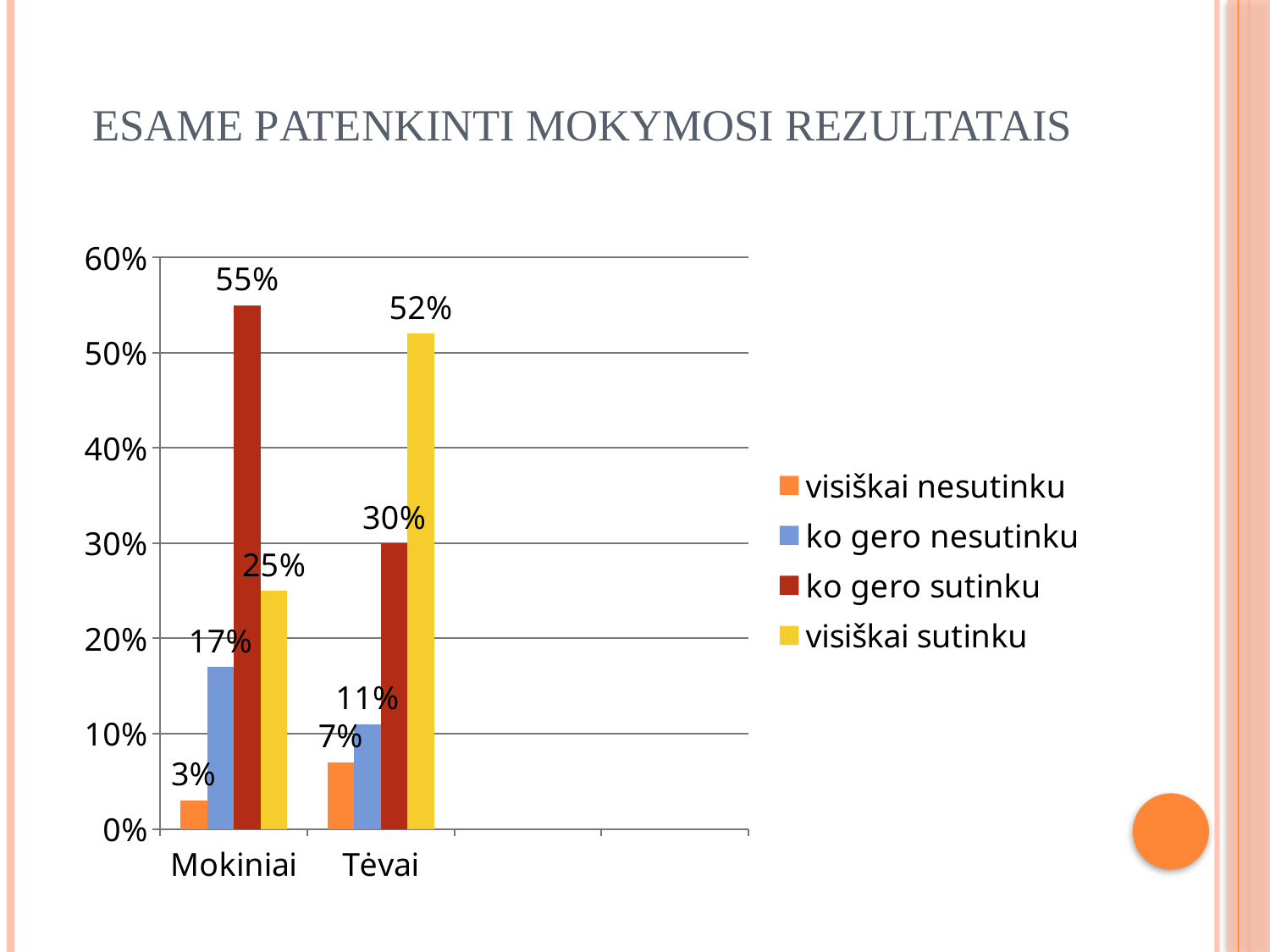
Which response category has the lowest value for Mokiniai? visiškai nesutinku What is the value for 'ko gero sutinku' for Mokiniai? 55% What kind of chart is shown on the slide? bar chart What is the title of the slide? ESAME PATENKINTI MOKYMOSI REZULTATAIS What is the value for 'visiškai nesutinku' for Mokiniai? 3% What is the value for 'visiškai sutinku' for Tėvai? 52% What is the value for 'ko gero nesutinku' for Tėvai? 11% What is the difference between 'ko gero sutinku' for Mokiniai and 'ko gero sutinku' for Tėvai? 25% How many series does the legend list? 4 Which response category has the highest value for Tėvai? visiškai sutinku How many categories are shown on the x axis? 2 Which is larger: 'visiškai sutinku' for Mokiniai or 'visiškai sutinku' for Tėvai? Tėvai